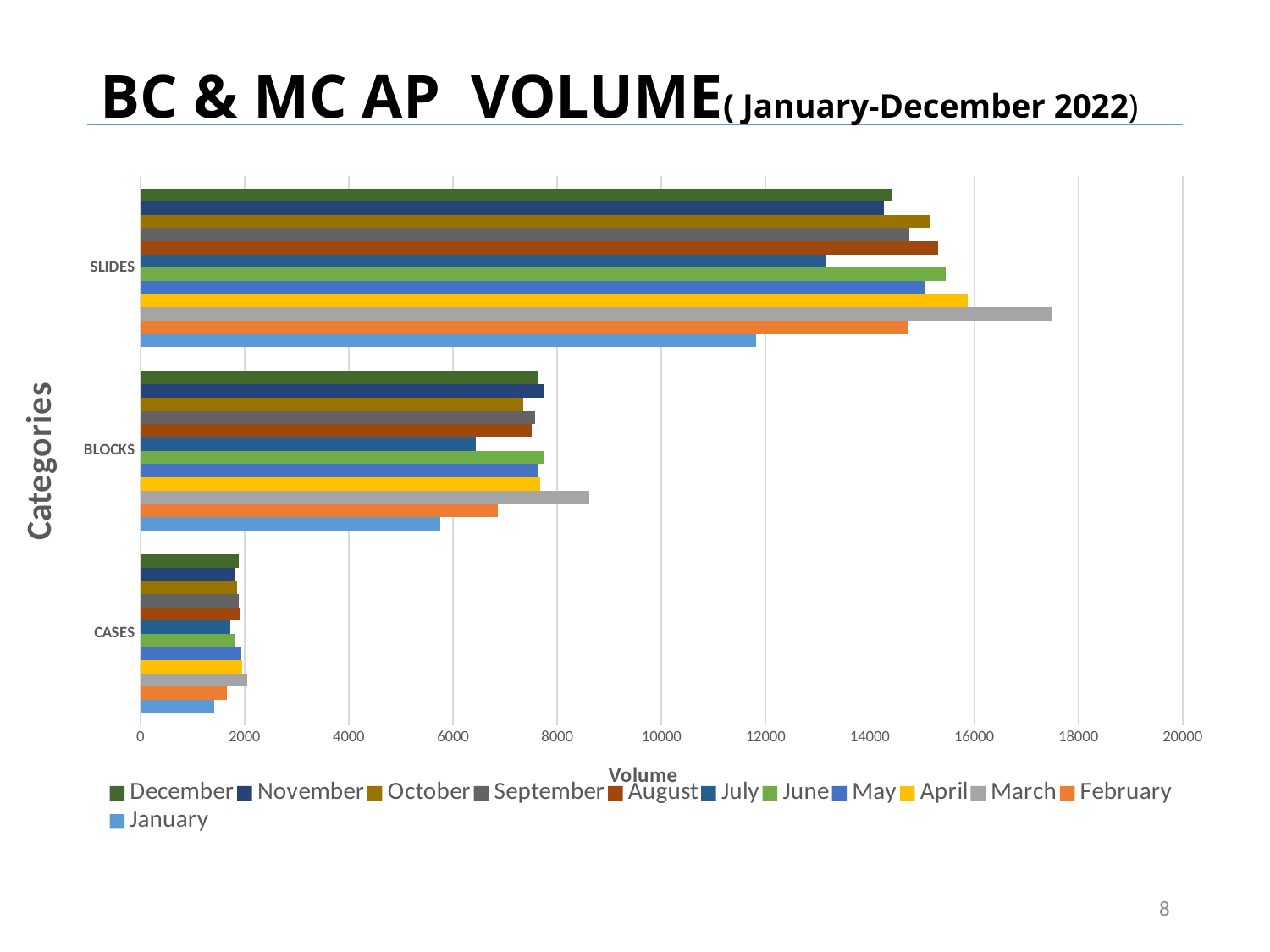
What kind of chart is shown on the slide? Bar chart Within the BLOCKS category, which month has the highest volume? March Which category has the longest bars overall in the chart? SLIDES How many series does the chart legend list? 12 Is the value for March in the SLIDES category greater or less than 16000? greater Is the value for January in the BLOCKS category greater or less than 6000? less Within the SLIDES category, which month has the highest volume? March Which is larger in the BLOCKS category: the value for March or the value for July? March Within the SLIDES category, which month has the lowest volume? January How many categories are shown on the vertical axis of the chart? 3 What is the label of the horizontal axis of the chart? Volume Which category has the shortest bars overall in the chart? CASES